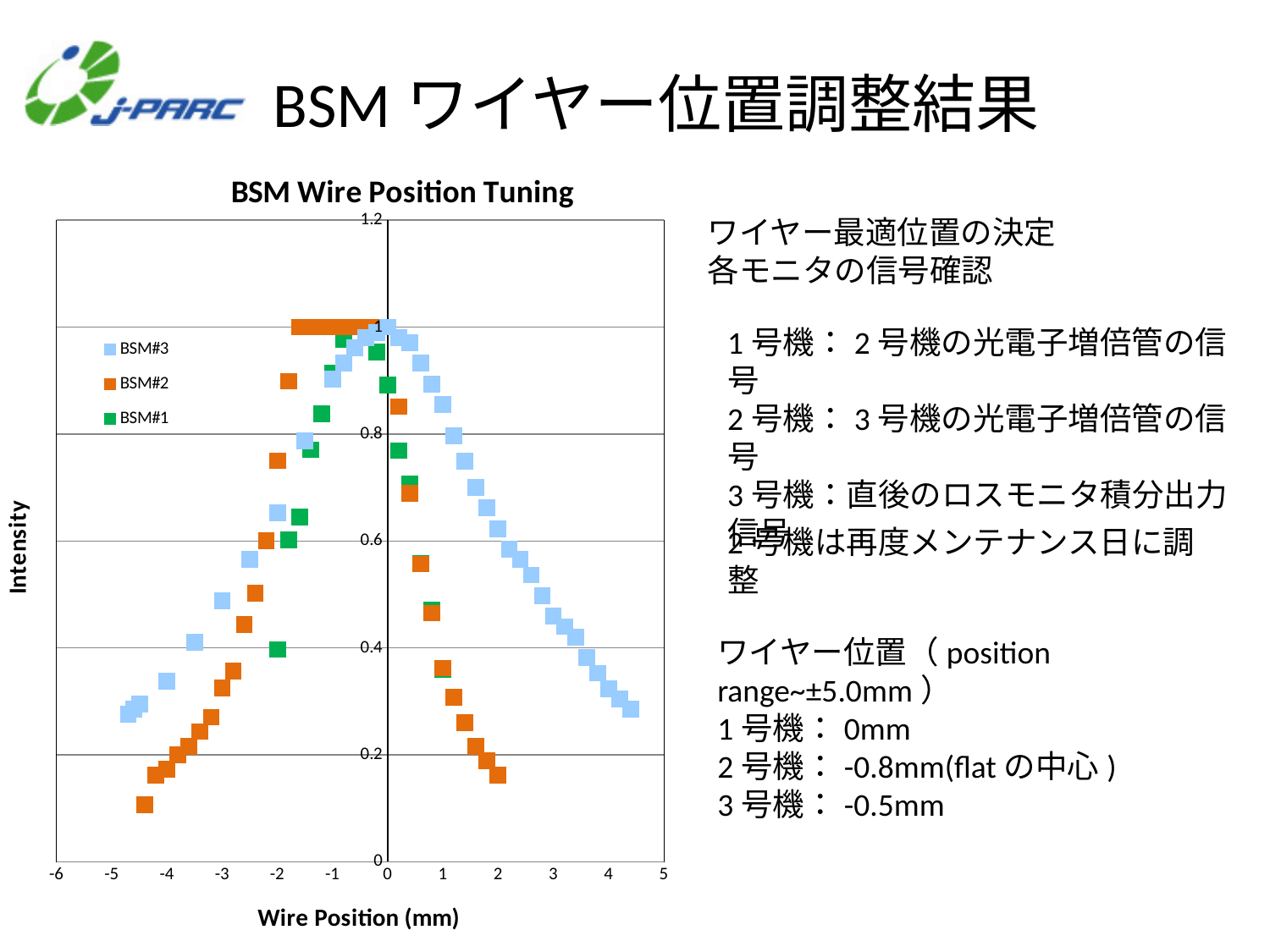
Is the BSM#2 intensity at wire position 2 mm greater or less than 0.4? less Which series extends to the largest positive wire position in the chart? BSM#3 How many series does the legend of the BSM Wire Position Tuning chart list? 3 Is the BSM#3 intensity at wire position 2 mm greater or less than 0.4? greater What kind of chart is shown on the slide? Scatter chart What is the label of the horizontal axis of the chart? Wire Position (mm) What is the title of the chart on the slide? BSM Wire Position Tuning Is the BSM#2 intensity at wire position -4.4 mm greater or less than 0.2? less Do the BSM#3 intensity values rise or fall as the wire position increases from 0 mm to 4.4 mm? fall Do the BSM#2 intensity values rise or fall as the wire position increases from -4.4 mm to -1.5 mm? rise Which series in the chart is plotted in orange? BSM#2